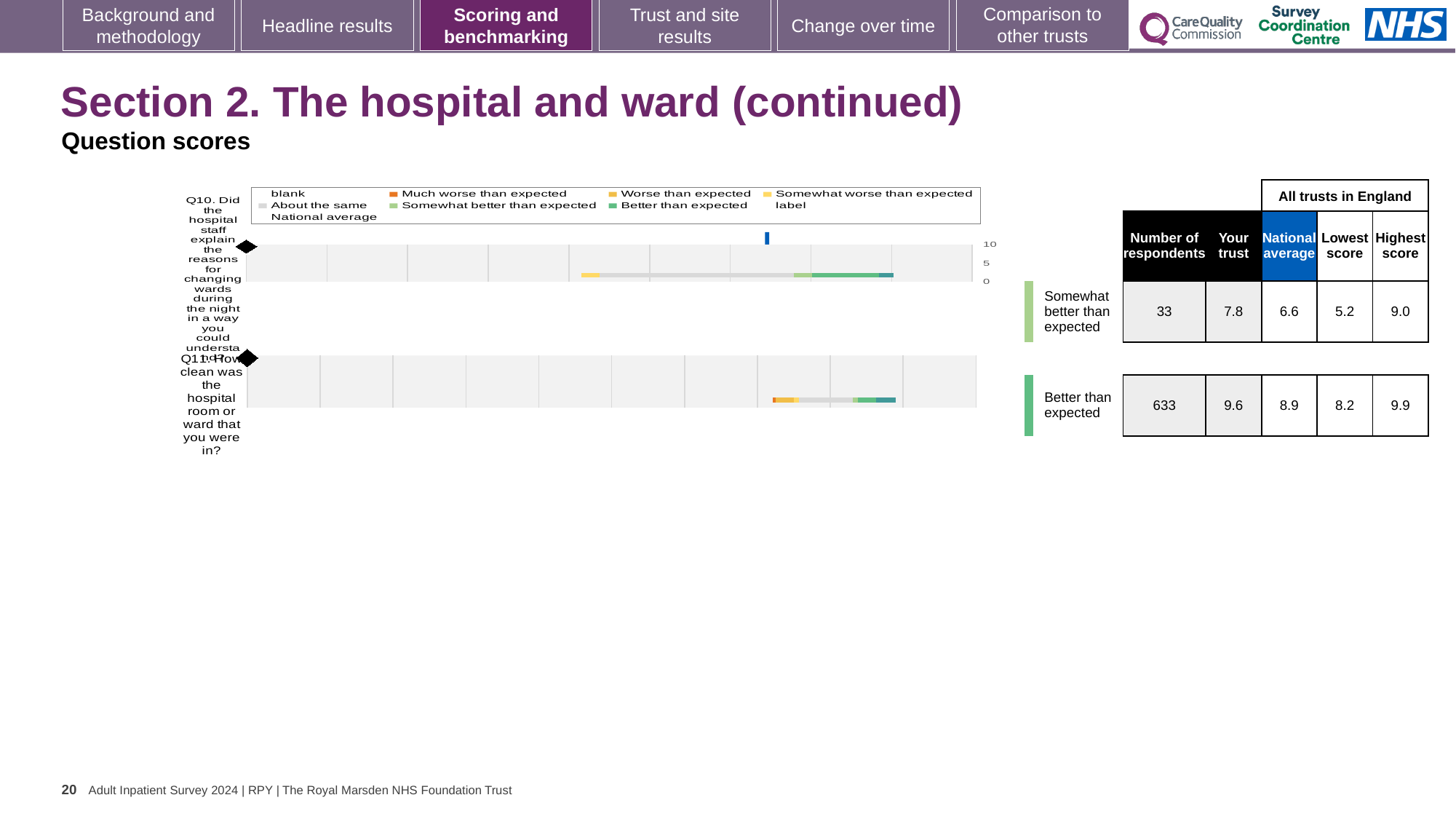
What is the national average score for Q10? 6.6 How many respondents answered Q11? 633 Which question has the higher 'Your trust' score, Q10 or Q11? Q11 What kind of chart is used to show the question scores for Q10 and Q11? bar chart What is the 'Your trust' score for Q10 (explaining reasons for changing wards during the night)? 7.8 Which benchmark category is Q11 placed in? Better than expected By how much does the trust's score for Q11 exceed the national average? 0.7 What is the highest score among all trusts in England for Q11? 9.9 What is the 'Your trust' score for Q11 (how clean was the hospital room or ward)? 9.6 What is the lowest score among all trusts in England for Q10? 5.2 How many questions are plotted on the slide? 2 By how much does the trust's score for Q10 exceed the national average? 1.2